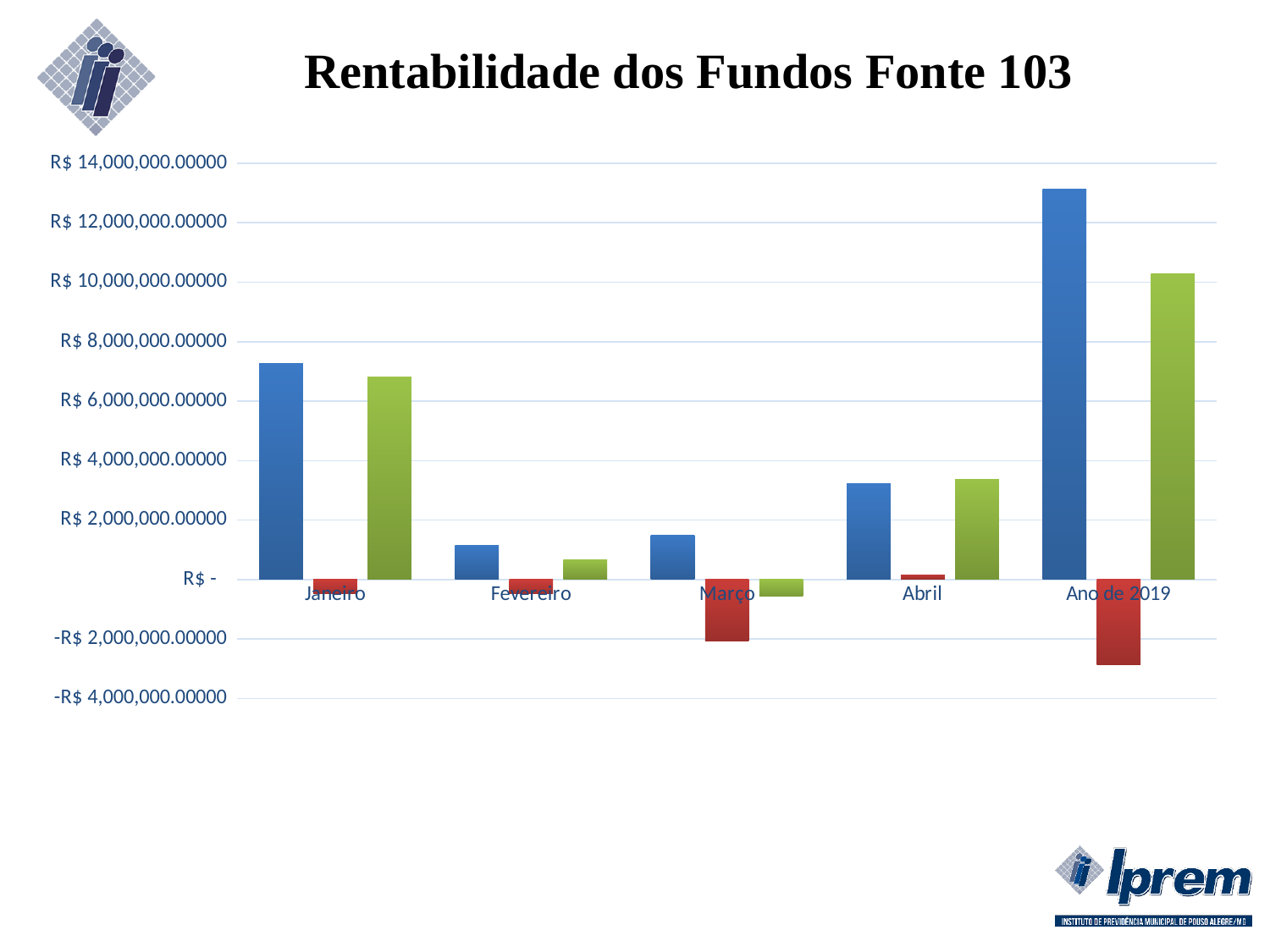
Is the blue bar for Fevereiro greater or less than R$ 2,000,000.00000? less What is the title of the chart? Rentabilidade dos Fundos Fonte 103 Is the blue bar for Ano de 2019 greater or less than R$ 12,000,000.00000? greater Is the red bar for Ano de 2019 greater or less than -R$ 2,000,000.00000? less What kind of chart is shown on the slide? bar chart Which category contains the lowest (most negative) bar in the chart? Ano de 2019 For Ano de 2019, which is larger, the blue bar or the green bar? the blue bar How many categories are shown on the x axis of the chart? 5 How many bars are plotted for each category in the chart? 3 Among the months Janeiro, Fevereiro, Março and Abril, which has the tallest blue bar? Janeiro Which category has the tallest bar in the chart? Ano de 2019